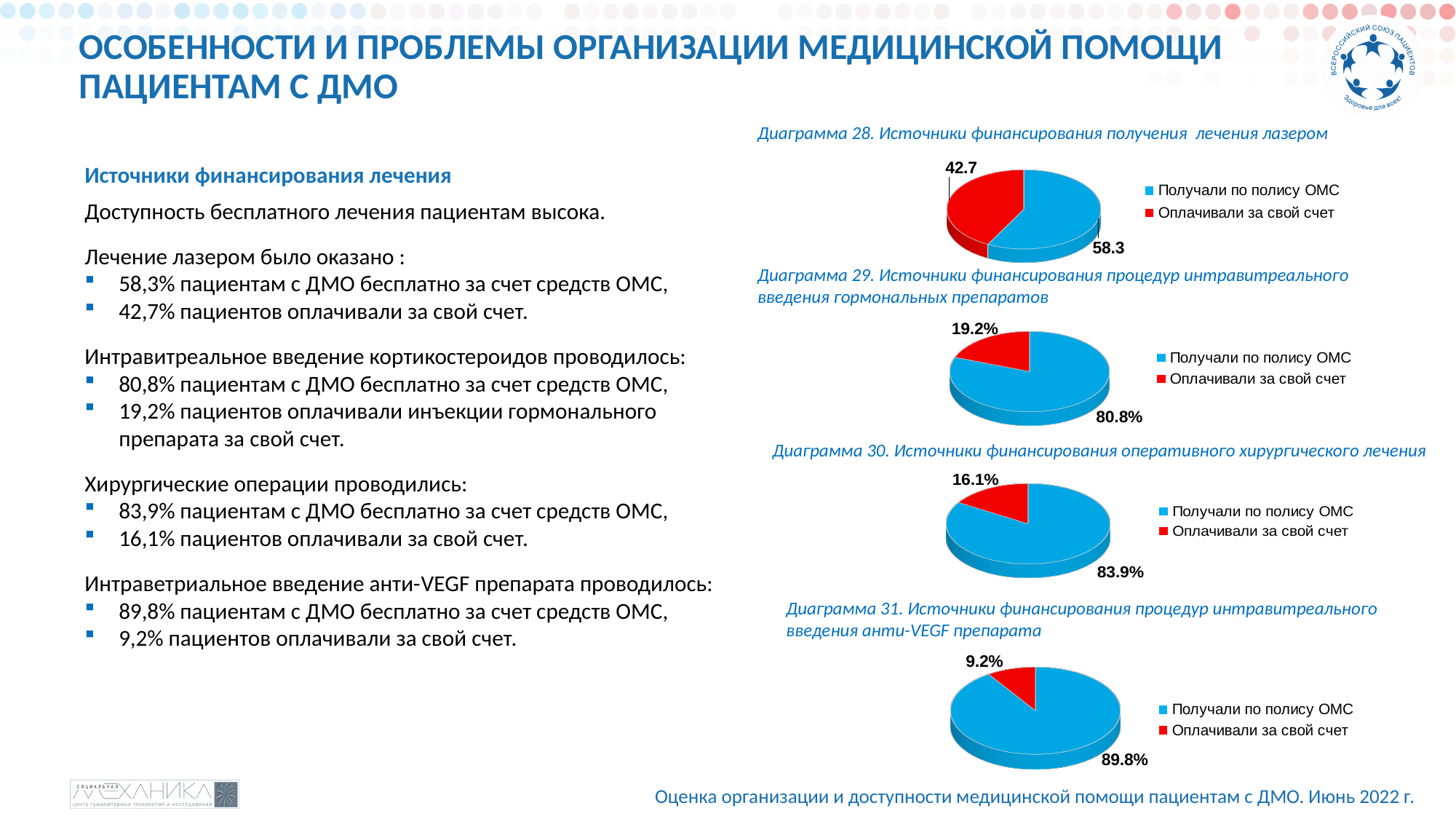
In Диаграмма 29 (Источники финансирования процедур интравитреального введения гормональных препаратов), what share is labelled for «Получали по полису ОМС»? 80.8% In Диаграмма 31 (Источники финансирования процедур интравитреального введения анти-VEGF препарата), which slice is the largest? Получали по полису ОМС In Диаграмма 29 (Источники финансирования процедур интравитреального введения гормональных препаратов), what share is labelled for «Оплачивали за свой счет»? 19.2% In Диаграмма 28 (Источники финансирования получения лечения лазером), what value is shown for «Получали по полису ОМС»? 58.3 In Диаграмма 28 (Источники финансирования получения лечения лазером), what value is shown for «Оплачивали за свой счет»? 42.7 In Диаграмма 28 (Источники финансирования получения лечения лазером), what is the difference between the «Получали по полису ОМС» and «Оплачивали за свой счет» values? 15.6 How many entries does the legend of Диаграмма 31 (Источники финансирования процедур интравитреального введения анти-VEGF препарата) list? 2 In Диаграмма 30 (Источники финансирования оперативного хирургического лечения), what share is labelled for «Получали по полису ОМС»? 83.9% In Диаграмма 29 (Источники финансирования процедур интравитреального введения гормональных препаратов), which is larger: «Получали по полису ОМС» or «Оплачивали за свой счет»? Получали по полису ОМС What type of chart is Диаграмма 30 (Источники финансирования оперативного хирургического лечения)? Pie chart In Диаграмма 31 (Источники финансирования процедур интравитреального введения анти-VEGF препарата), what share is labelled for «Оплачивали за свой счет»? 9.2% In Диаграмма 30 (Источники финансирования оперативного хирургического лечения), which slice is the smallest? Оплачивали за свой счет